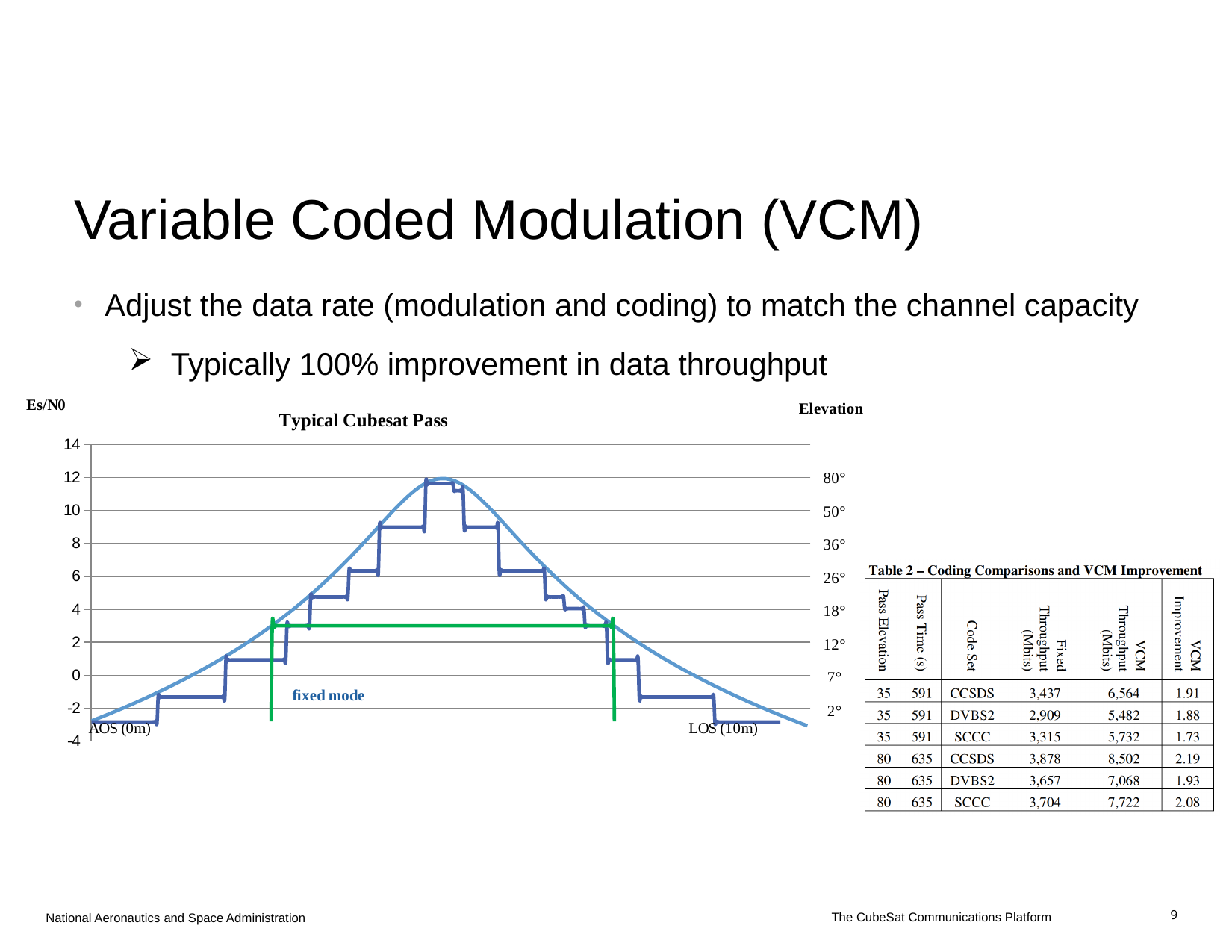
In the "Typical Cubesat Pass" chart, is the Es/N0 value at AOS (0m) greater or less than 0? less What is the lowest tick value shown on the Es/N0 axis of the "Typical Cubesat Pass" chart? -4 In the "Typical Cubesat Pass" chart, is the green "fixed mode" line greater or less than 2 on the Es/N0 axis? greater What kind of chart is the "Typical Cubesat Pass" chart? line chart In the "Typical Cubesat Pass" chart, is the green "fixed mode" line greater or less than 4 on the Es/N0 axis? less How many elevation labels are shown on the right side of the "Typical Cubesat Pass" chart? 8 What quantity is labelled on the left vertical axis of the "Typical Cubesat Pass" chart? Es/N0 What is the title of the chart on the slide? Typical Cubesat Pass What is the highest tick value shown on the Es/N0 axis of the "Typical Cubesat Pass" chart? 14 How does the Es/N0 curve in the "Typical Cubesat Pass" chart change from AOS (0m) to LOS (10m)? rises then falls